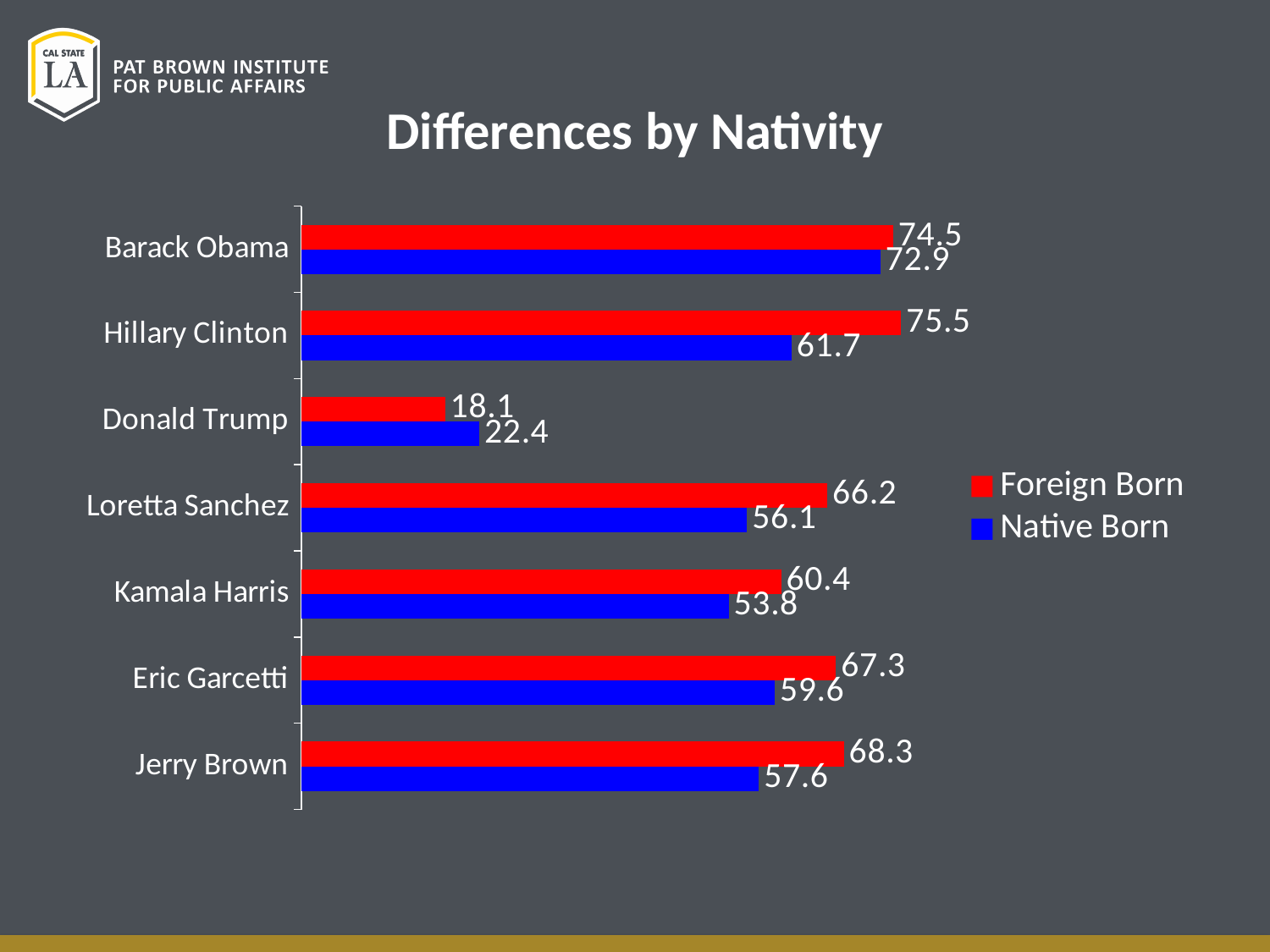
What is the difference between the Foreign Born and Native Born values for Hillary Clinton? 13.8 Which person has the lowest Native Born value? Donald Trump How many series does the legend list? 2 What is the difference between the Foreign Born and Native Born values for Jerry Brown? 10.7 For Donald Trump, which is larger: the Foreign Born value or the Native Born value? Native Born Which is larger: the Native Born value for Barack Obama or the Native Born value for Loretta Sanchez? Barack Obama What is the Native Born value for Donald Trump? 22.4 What is the Native Born value for Kamala Harris? 53.8 What is the Foreign Born value for Hillary Clinton? 75.5 What kind of chart is shown on the slide? Bar chart How many people are shown on the chart? 7 Which person has the highest Foreign Born value? Hillary Clinton